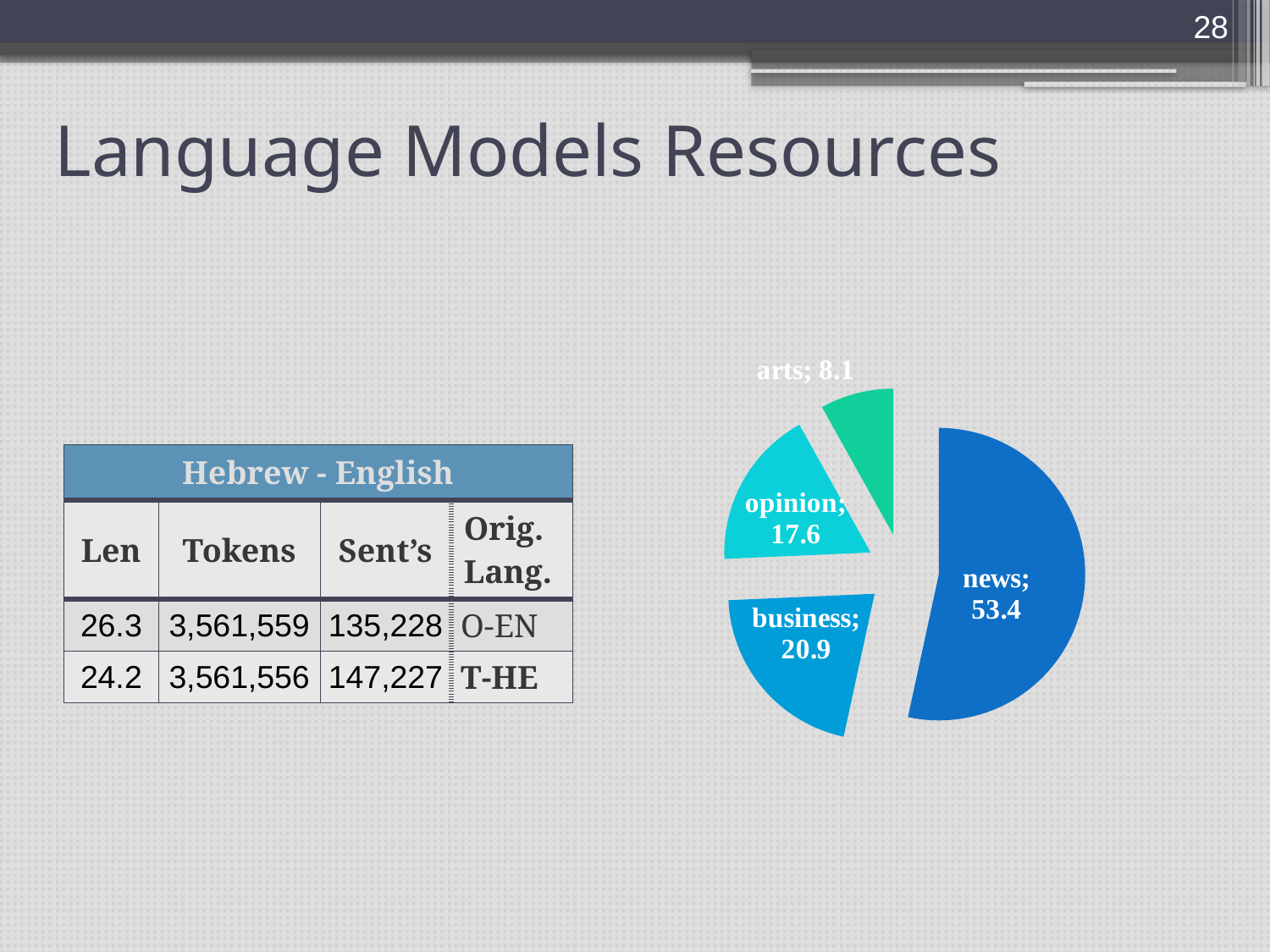
How many slices does the pie chart have? 4 What is the value shown for the arts slice in the pie chart? 8.1 Which category has the smallest slice in the pie chart? arts What is the value shown for the opinion slice in the pie chart? 17.6 What is the difference between the business and opinion values in the pie chart? 3.3 Which category has the largest slice in the pie chart? news Which is larger in the pie chart, the opinion slice or the arts slice? opinion What is the value shown for the business slice in the pie chart? 20.9 What is the difference between the news and business values in the pie chart? 32.5 What is the value shown for the news slice in the pie chart? 53.4 What kind of chart is shown on the slide? pie chart What colour is the news slice in the pie chart? blue